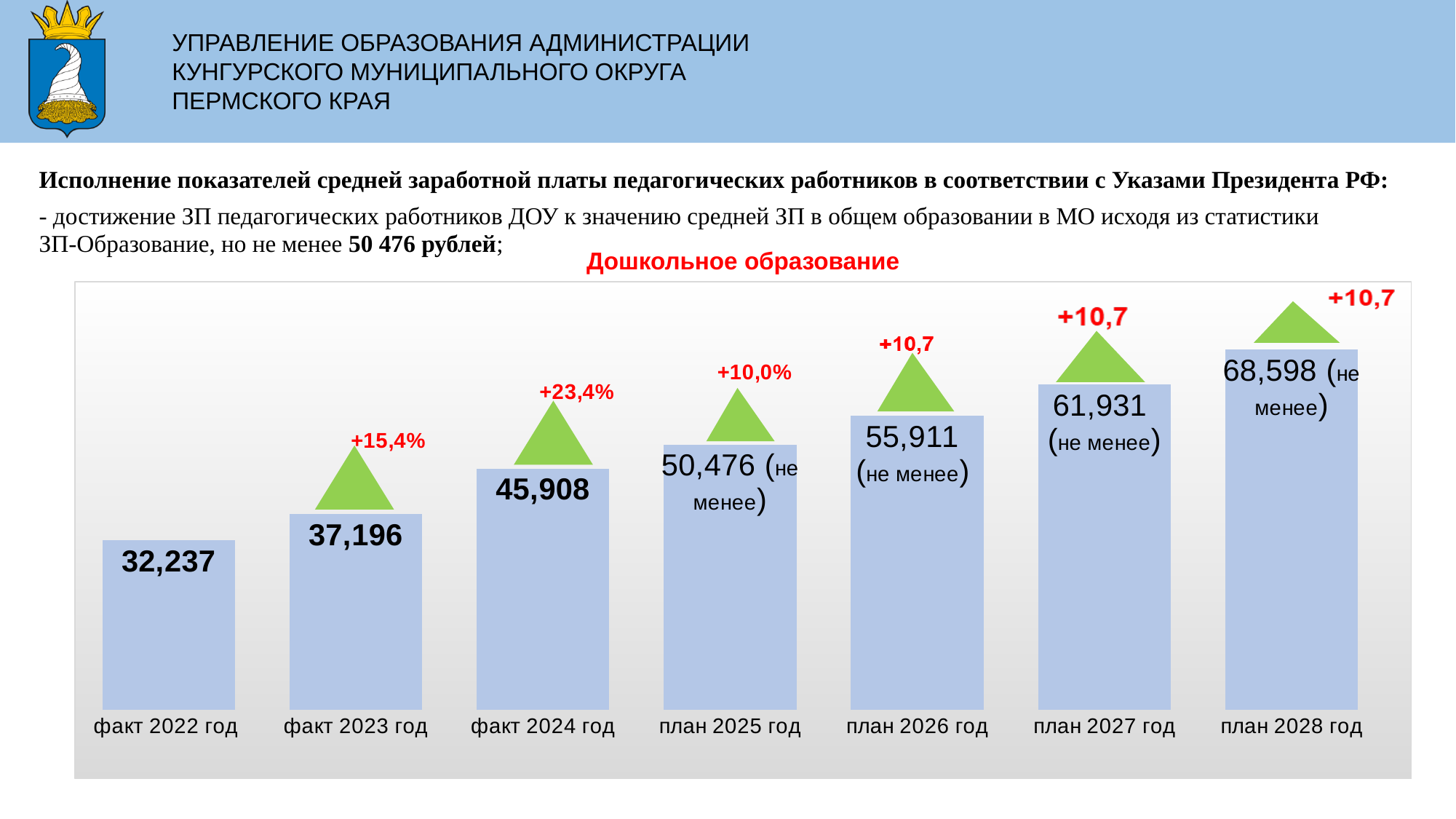
What is the value shown for факт 2022 год? 32,237 Which category has the lowest value? факт 2022 год What is the difference between the values for факт 2024 год and факт 2023 год? 8,712 How many categories (bars) are shown in the chart? 7 What is the difference between the values for факт 2023 год and факт 2022 год? 4,959 What is the value shown for план 2026 год? 55,911 What is the value shown for факт 2024 год? 45,908 Do the values rise or fall from факт 2022 год to план 2028 год? Rise Which is larger, the value for план 2025 год or the value for факт 2024 год? план 2025 год What is the value shown for план 2028 год? 68,598 Which category has the highest value? план 2028 год What kind of chart is shown on the slide? Bar chart